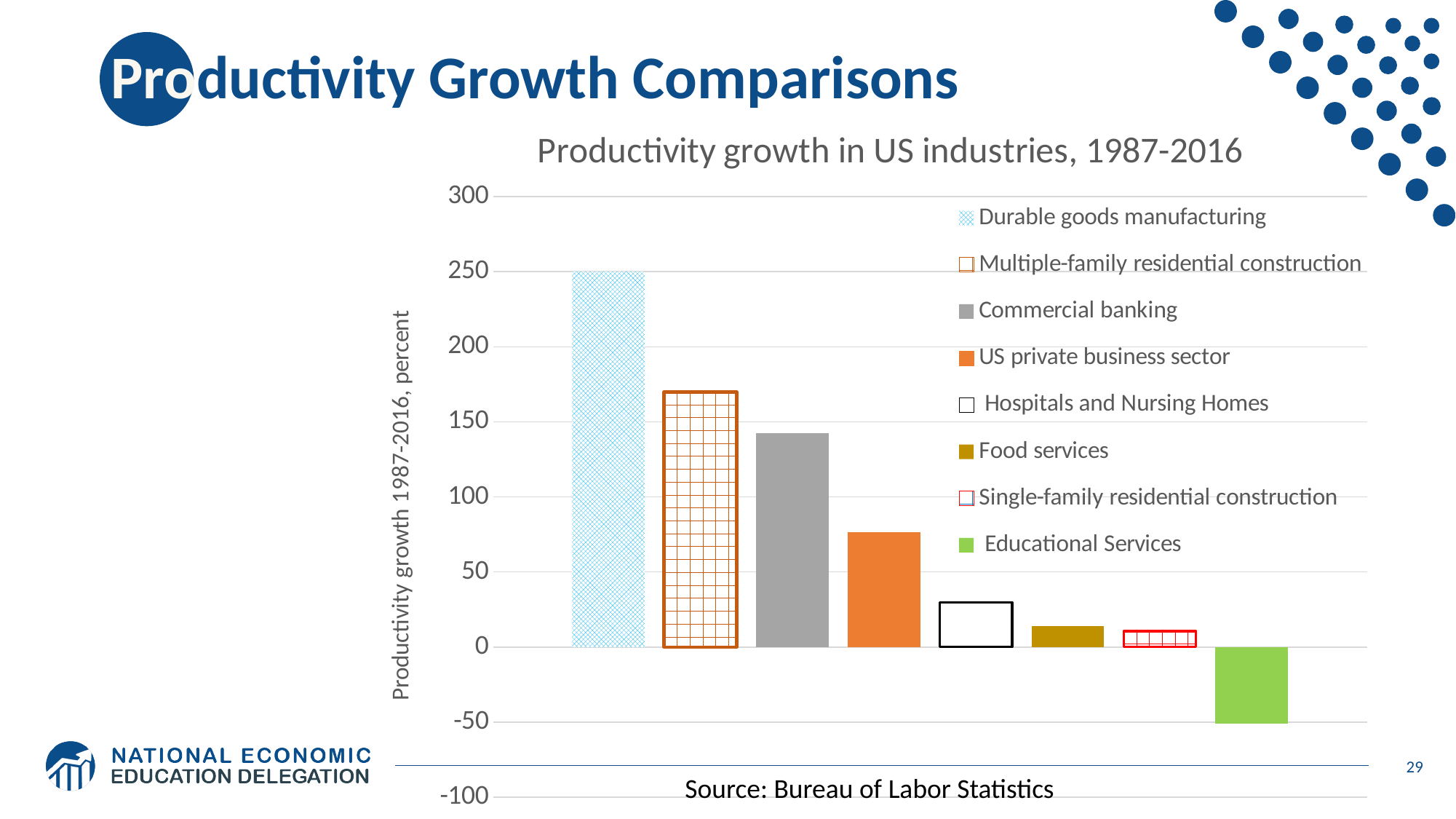
Which industry has the highest productivity growth in the chart? Durable goods manufacturing What kind of chart is shown on the slide? bar chart Is the value for Educational Services greater or less than 0? less Is the value for Multiple-family residential construction greater or less than 150? greater Which is larger, the value for Commercial banking or the value for US private business sector? Commercial banking Which is larger, the value for Hospitals and Nursing Homes or the value for Food services? Hospitals and Nursing Homes Is the value for Commercial banking greater or less than 150? less What is the title of the chart? Productivity growth in US industries, 1987-2016 Which industry has the lowest productivity growth in the chart? Educational Services What is the productivity growth value for Durable goods manufacturing? 250 How many series does the legend list? 8